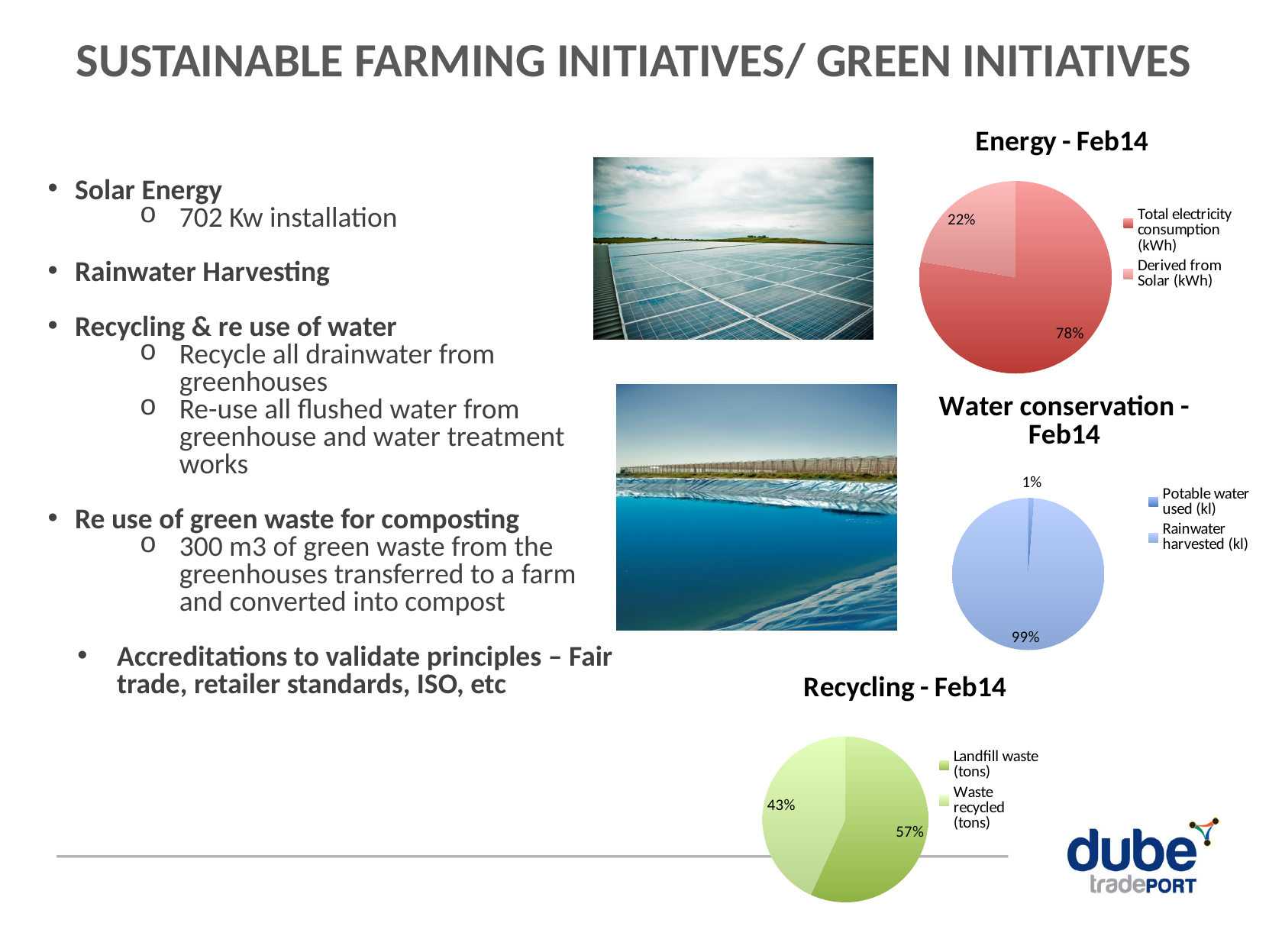
What kind of chart is the 'Recycling - Feb14' chart? Pie chart In the 'Recycling - Feb14' chart, what share of the pie is 'Landfill waste (tons)'? 57% In the 'Water conservation - Feb14' chart, what share of the pie is 'Rainwater harvested (kl)'? 99% In the 'Water conservation - Feb14' chart, which slice is the smallest? Potable water used (kl) In the 'Energy - Feb14' chart, which slice is the largest? Total electricity consumption (kWh) In the 'Recycling - Feb14' chart, which is larger, 'Landfill waste (tons)' or 'Waste recycled (tons)'? Landfill waste (tons) In the 'Recycling - Feb14' chart, what share of the pie is 'Waste recycled (tons)'? 43% How many entries does the legend of the 'Water conservation - Feb14' chart list? 2 In the 'Energy - Feb14' chart, what is the difference in percentage points between the two slices? 56